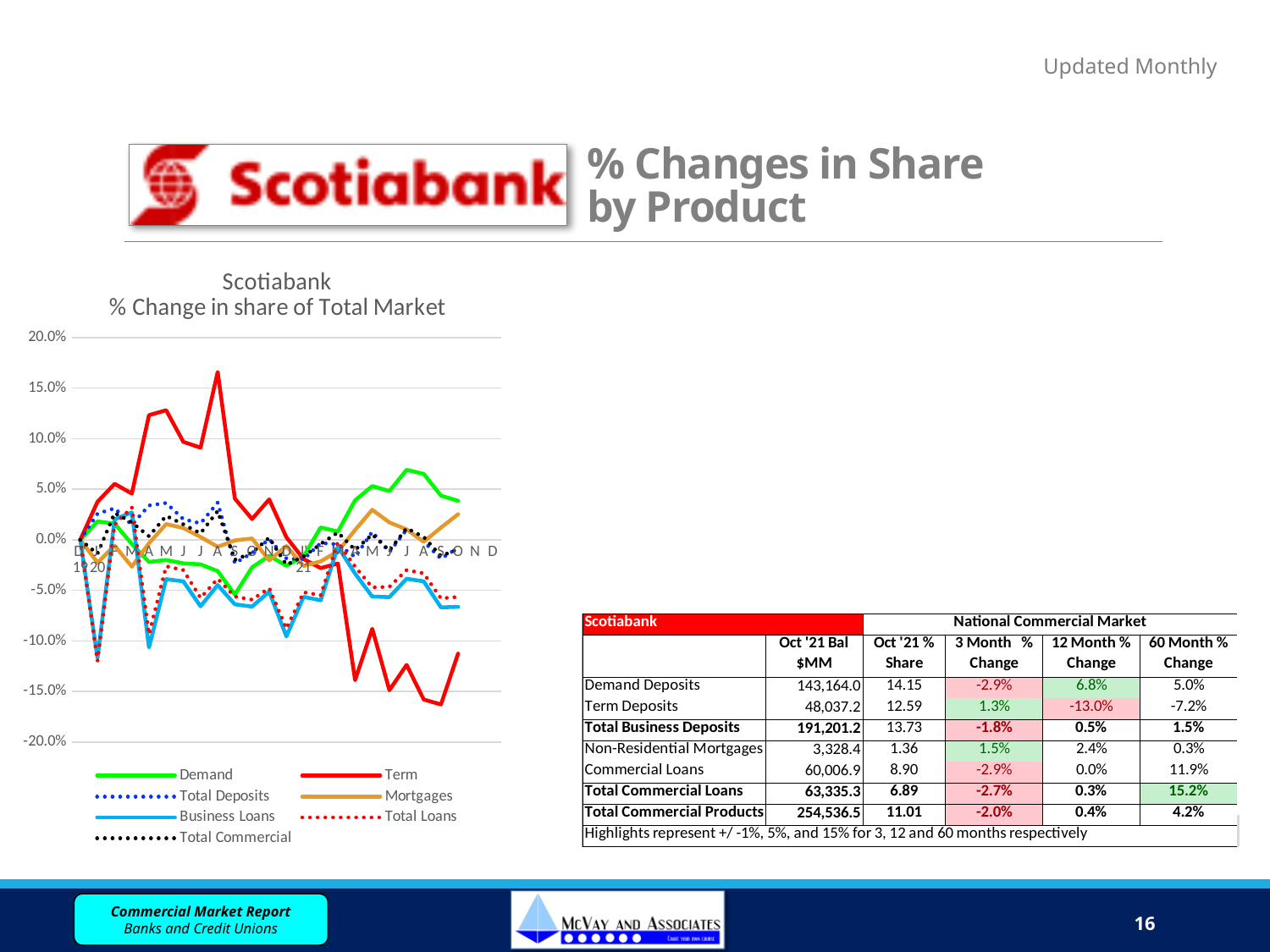
In the "Scotiabank % Change in share of Total Market" chart, is the peak value of the Demand series greater or less than 5.0%? greater In the "Scotiabank % Change in share of Total Market" chart, is the lowest value of the Business Loans series greater or less than -10.0%? less In the "Scotiabank % Change in share of Total Market" chart, is the lowest value of the Term series greater or less than -15.0%? less In the "Scotiabank % Change in share of Total Market" chart, what is the highest value shown on the vertical axis? 20.0% In the "Scotiabank % Change in share of Total Market" chart, which series reaches the lowest value on the chart? Term In the "Scotiabank % Change in share of Total Market" chart, which series reaches the highest value on the chart? Term How many series does the legend of the "Scotiabank % Change in share of Total Market" chart list? 7 In the "Scotiabank % Change in share of Total Market" chart, which series is drawn in green? Demand What kind of chart is the "Scotiabank % Change in share of Total Market" chart? line chart